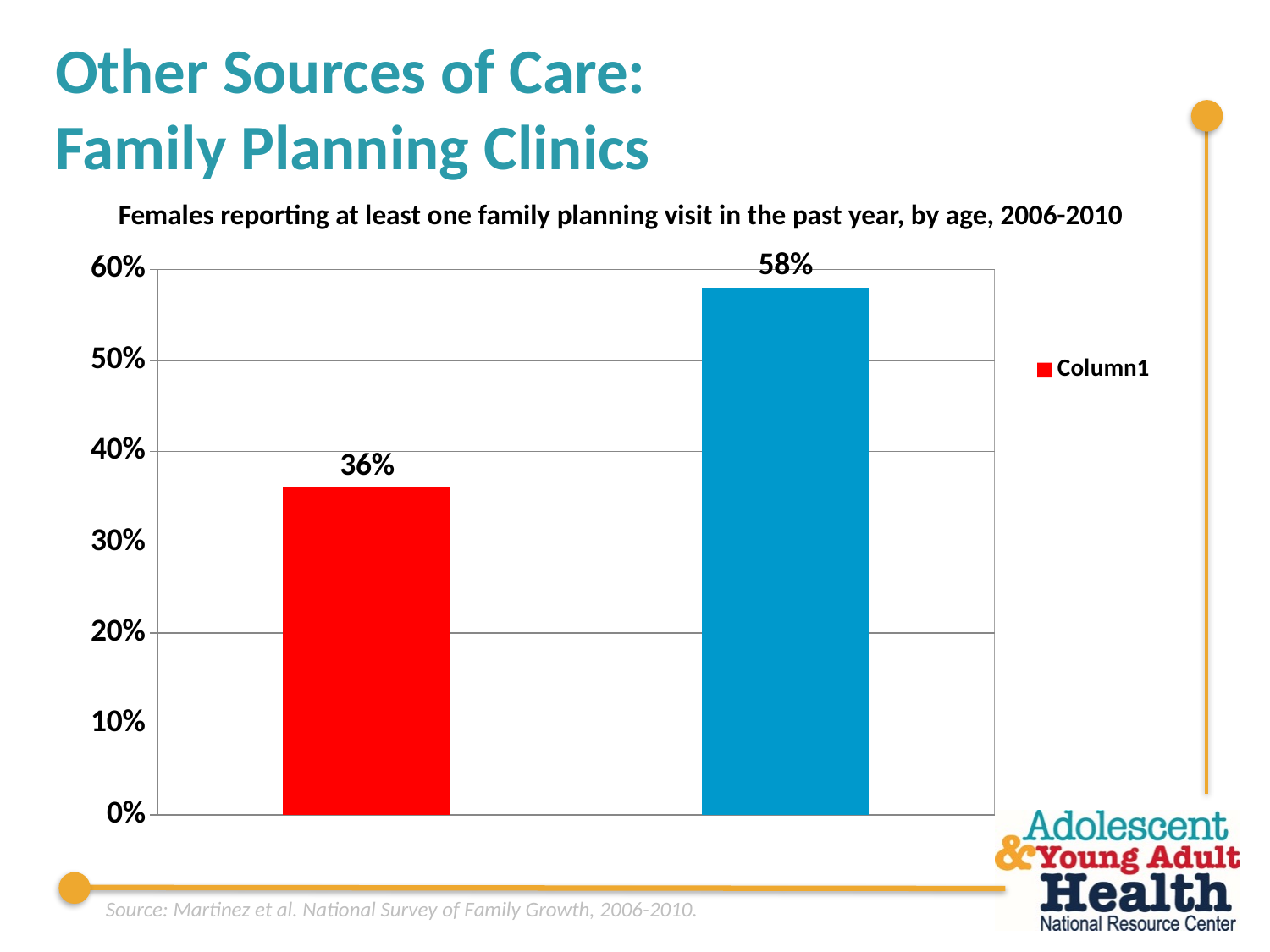
What is the title of the chart? Females reporting at least one family planning visit in the past year, by age, 2006-2010 Is the value of the blue bar greater or less than 50%? greater How many bars are plotted in the chart? 2 Which bar has the highest value, the red bar or the blue bar? the blue bar How many entries does the chart legend list? 1 Is the value of the red bar greater or less than 40%? less What kind of chart is shown on the slide? bar chart What value is shown on the red bar? 36% Which bar has the lowest value, the red bar or the blue bar? the red bar What is the difference between the blue bar's value and the red bar's value? 22 percentage points Is the value of the left bar larger or smaller than the value of the right bar? smaller What value is shown on the blue bar? 58%